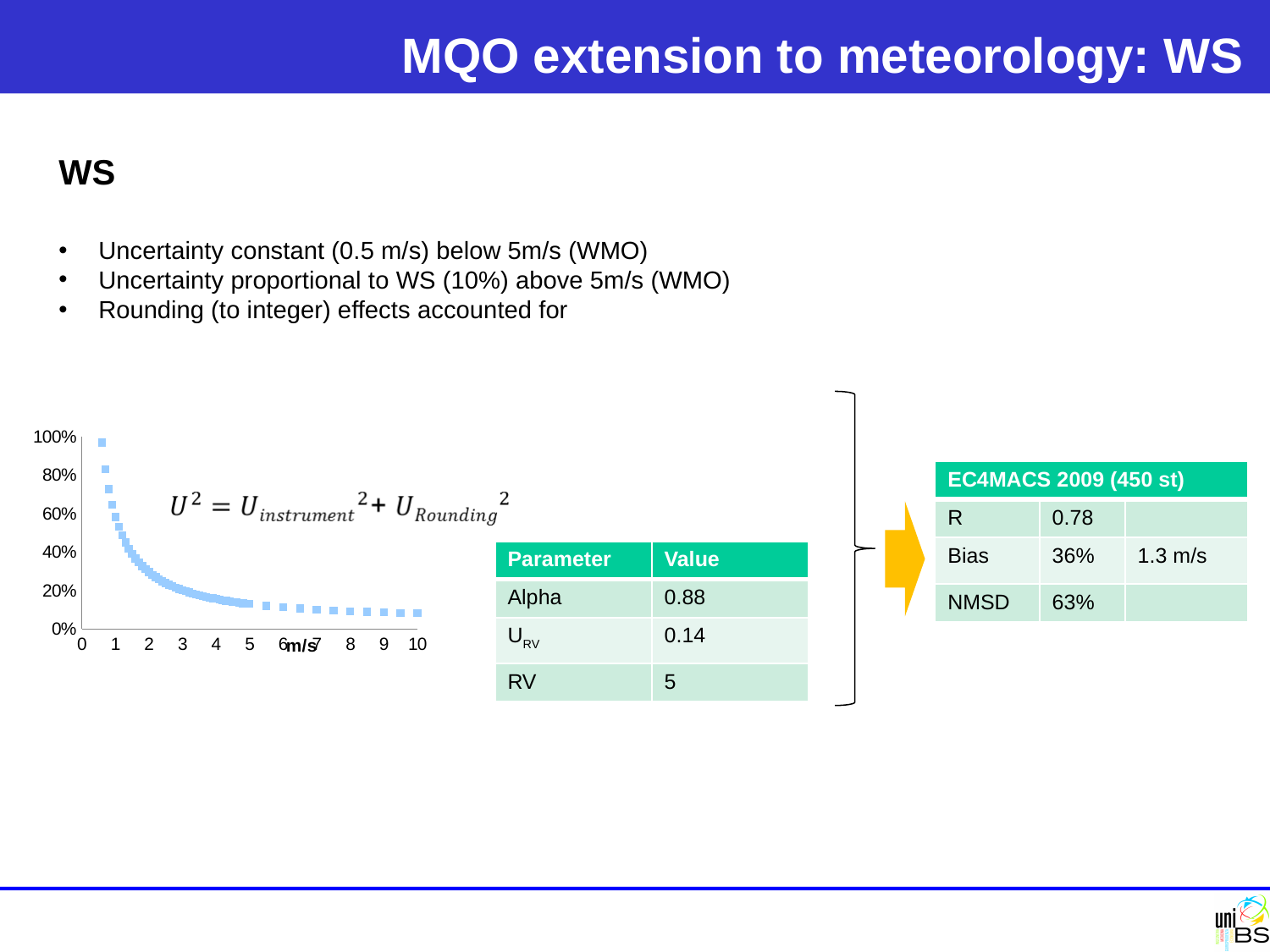
Is the plotted value at 2 m/s greater or less than 40%? less Is the plotted value at 10 m/s greater or less than 20%? less What unit is labelled on the x axis of the chart? m/s What is the maximum value shown on the y axis of the chart? 100% Is the highest plotted value greater or less than 80%? greater At which end of the x axis, 0 or 10 m/s, are the plotted values higher? 0 What kind of chart is shown on the slide? scatter chart Do the plotted values rise or fall as wind speed increases along the x axis? fall